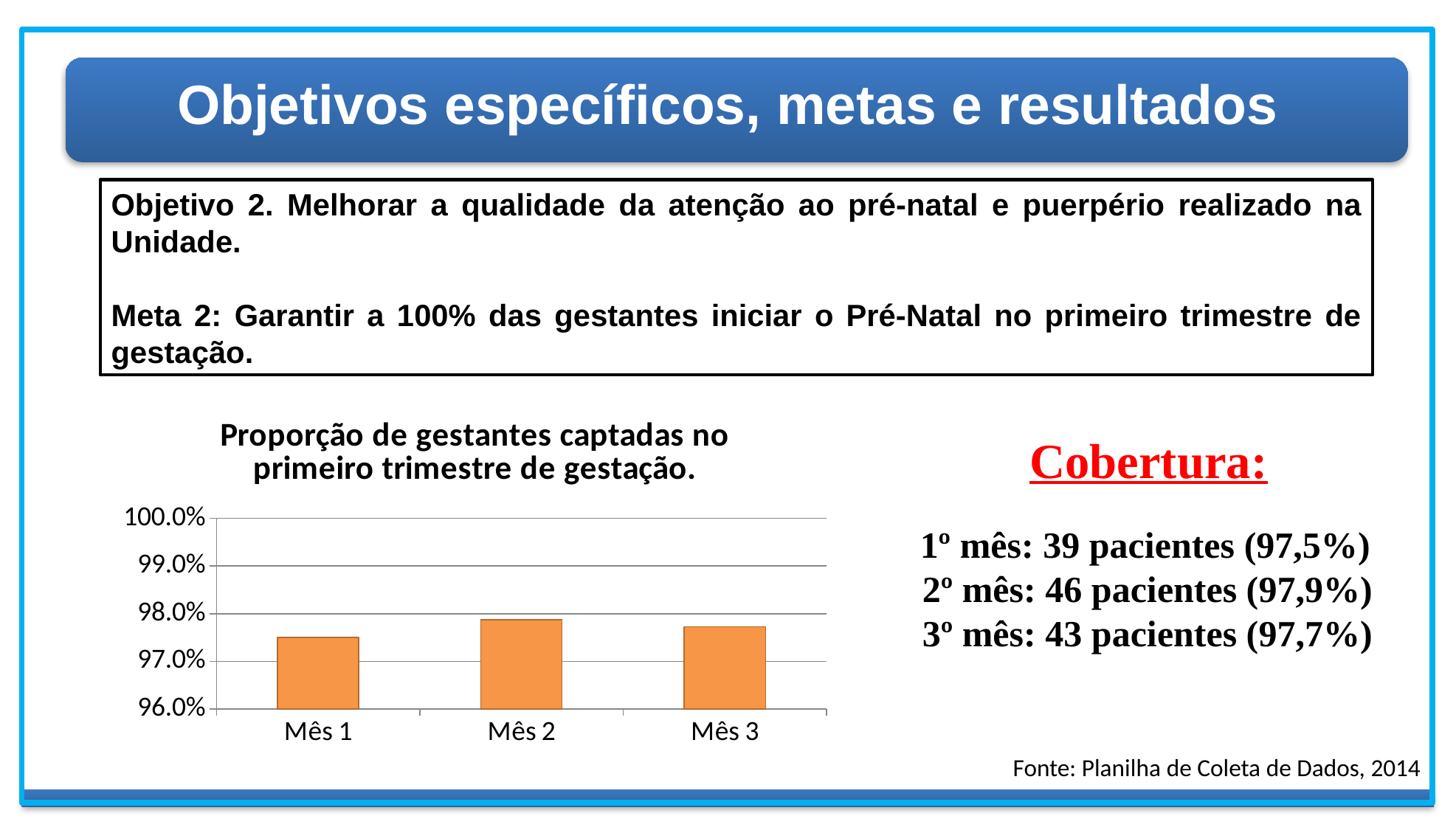
What kind of chart is shown on the slide? Bar chart Is the value for Mês 1 greater or less than 98.0%? less Which is larger, the value for Mês 1 or the value for Mês 2? Mês 2 Is the value for Mês 2 greater or less than 97.0%? greater What is the title of the chart? Proporção de gestantes captadas no primeiro trimestre de gestação. How many categories are shown on the x axis of the chart? 3 Is the value for Mês 3 greater or less than 98.0%? less Which month has the highest bar in the chart? Mês 2 Which month has the lowest bar in the chart? Mês 1 Does the value rise or fall from Mês 1 to Mês 2? rise What is the lowest value shown on the chart's y axis? 96.0%